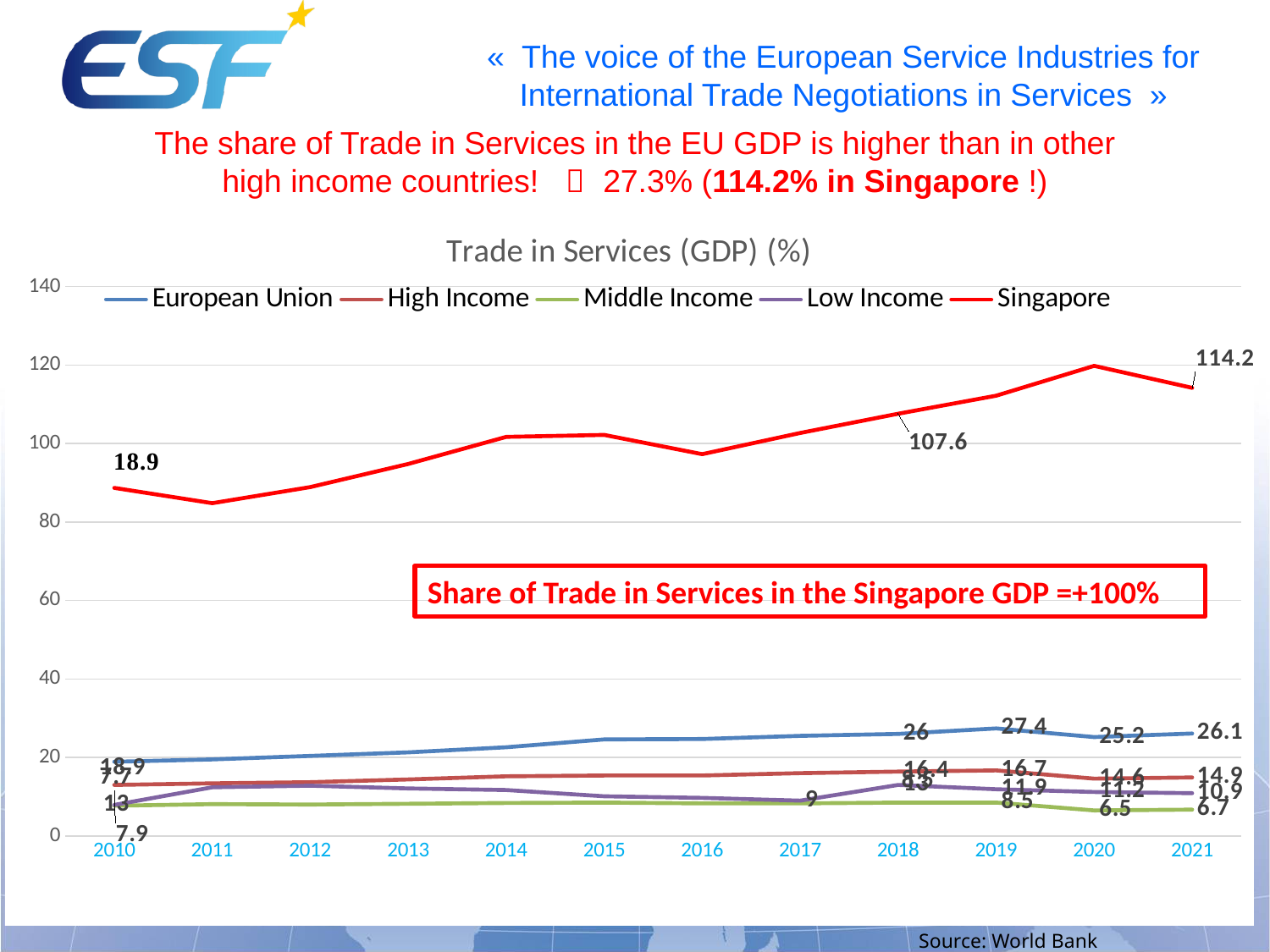
Which series has the highest value in 2021? Singapore What is the value for Middle Income in 2020? 6.5 What is the value for Singapore in 2021? 114.2 Is the value for Singapore in 2020 greater or less than 100? greater What is the difference between the European Union value and the High Income value in 2021? 11.2 How many series does the legend of the chart list? 5 What is the value for the European Union in 2019? 27.4 What is the value for Singapore in 2018? 107.6 How many years are shown along the x axis of the chart? 12 What kind of chart is shown on the slide? Line chart What is the title of the chart? Trade in Services (GDP) (%) What is the value for High Income in 2021? 14.9